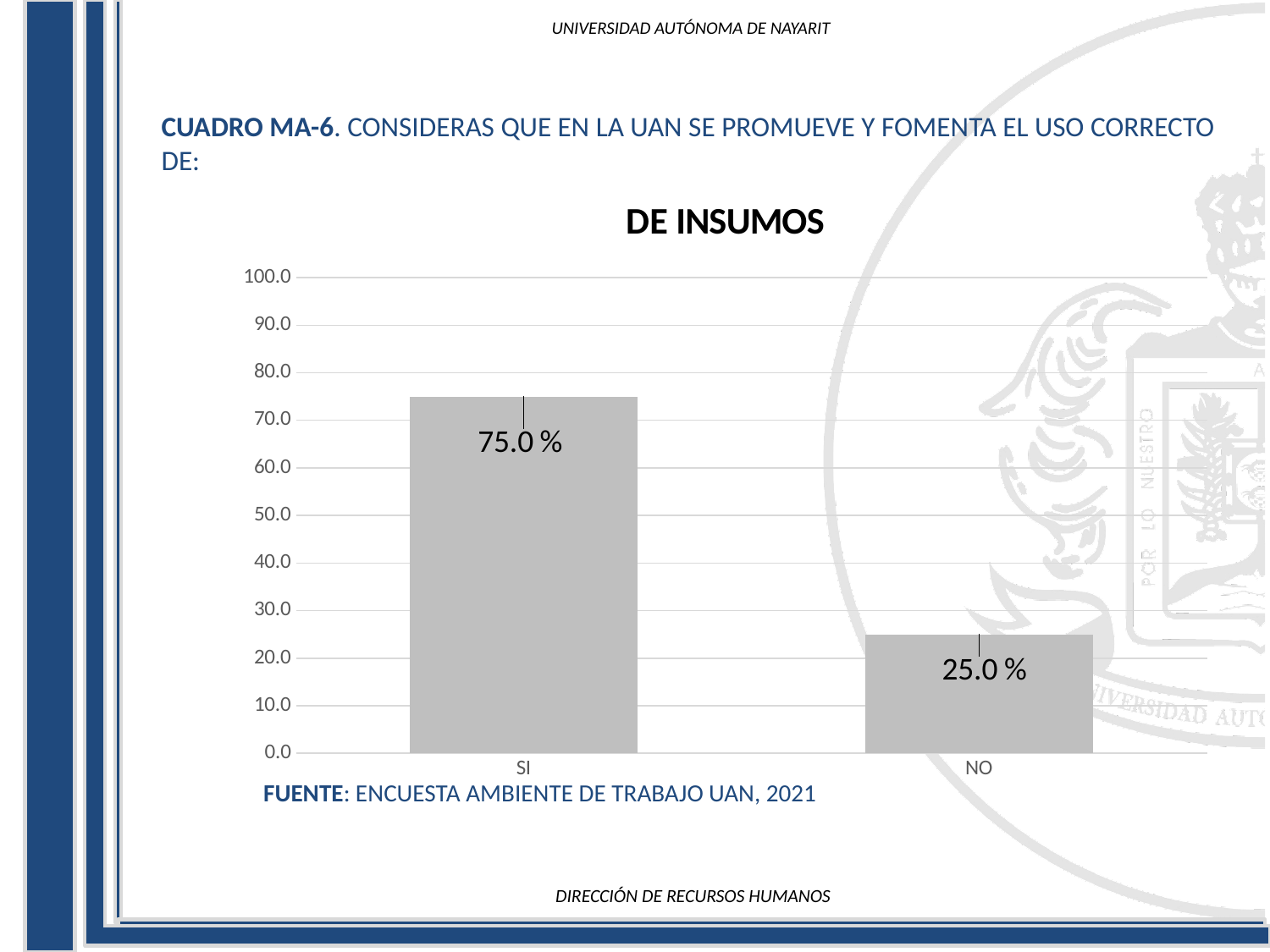
What kind of chart is shown on the slide? bar chart Which is larger, the value for SI or the value for NO? SI Is the value for NO greater or less than 30.0? less How many categories are shown in the chart? 2 What is the difference between the values for SI and NO? 50.0 % Which category has the lowest value? NO What is the value for SI? 75.0 % What is the value for NO? 25.0 % What is the title of the chart? DE INSUMOS Is the value for SI greater or less than 70.0? greater Which category has the highest value? SI What is the highest value shown on the vertical axis? 100.0